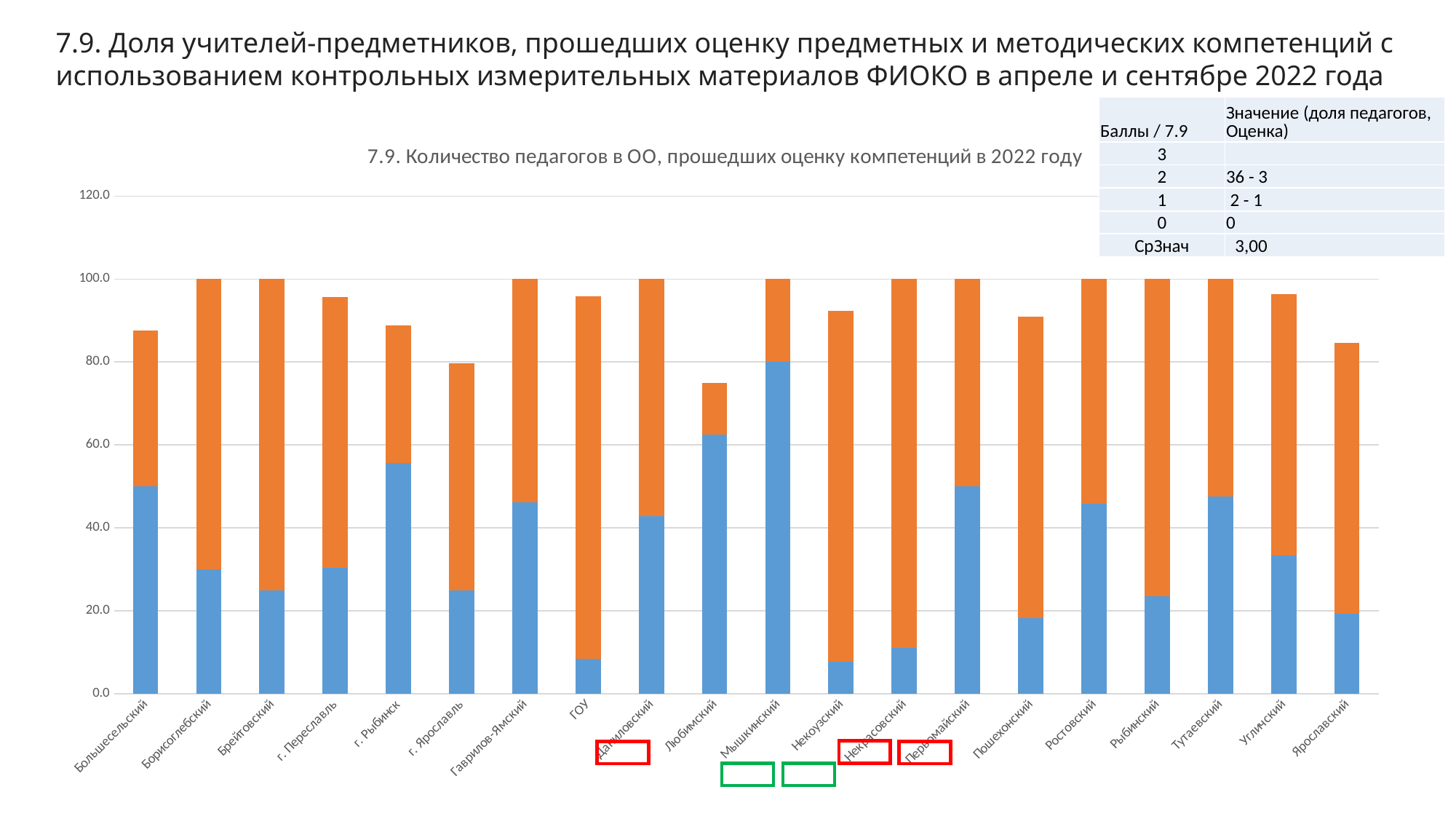
Which has the taller total bar, Любимский or Ярославский? Ярославский Is the blue segment for Некоузский greater or less than 20.0? less What is the total height of the stacked bar for Борисоглебский? 100.0 Which has the taller blue segment, г. Рыбинск or Большесельский? г. Рыбинск Is the total height of the bar for Пошехонский greater or less than 80.0? greater Which category has the tallest blue segment? Мышкинский Is the total height of the bar for Любимский greater or less than 80.0? less What two colours are used for the segments of the stacked bars? blue and orange How many categories (districts) are shown along the x axis of the chart? 20 What kind of chart is shown on the slide? bar chart What is the title of the chart? 7.9. Количество педагогов в ОО, прошедших оценку компетенций в 2022 году